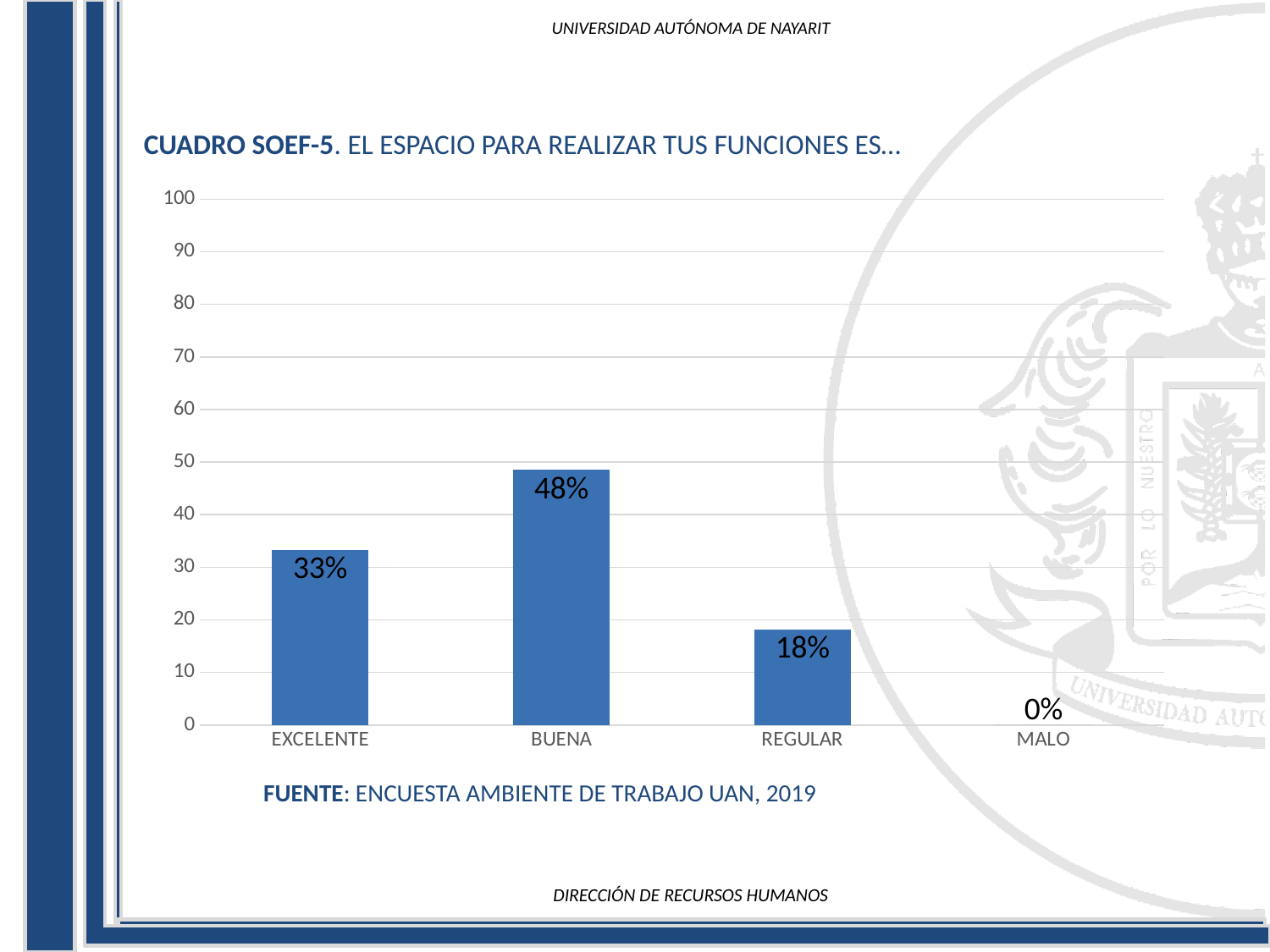
What is the difference between the values for BUENA and EXCELENTE? 15% How many categories are shown on the x axis? 4 What kind of chart is shown on the slide? bar chart What is the value for BUENA? 48% What is the value for EXCELENTE? 33% Is the value for BUENA greater or less than 40? greater Which is larger, the value for EXCELENTE or the value for REGULAR? EXCELENTE What is the value for MALO? 0% What is the value for REGULAR? 18% Which category has the highest value? BUENA Which category has the lowest value? MALO What is the source cited below the chart? ENCUESTA AMBIENTE DE TRABAJO UAN, 2019